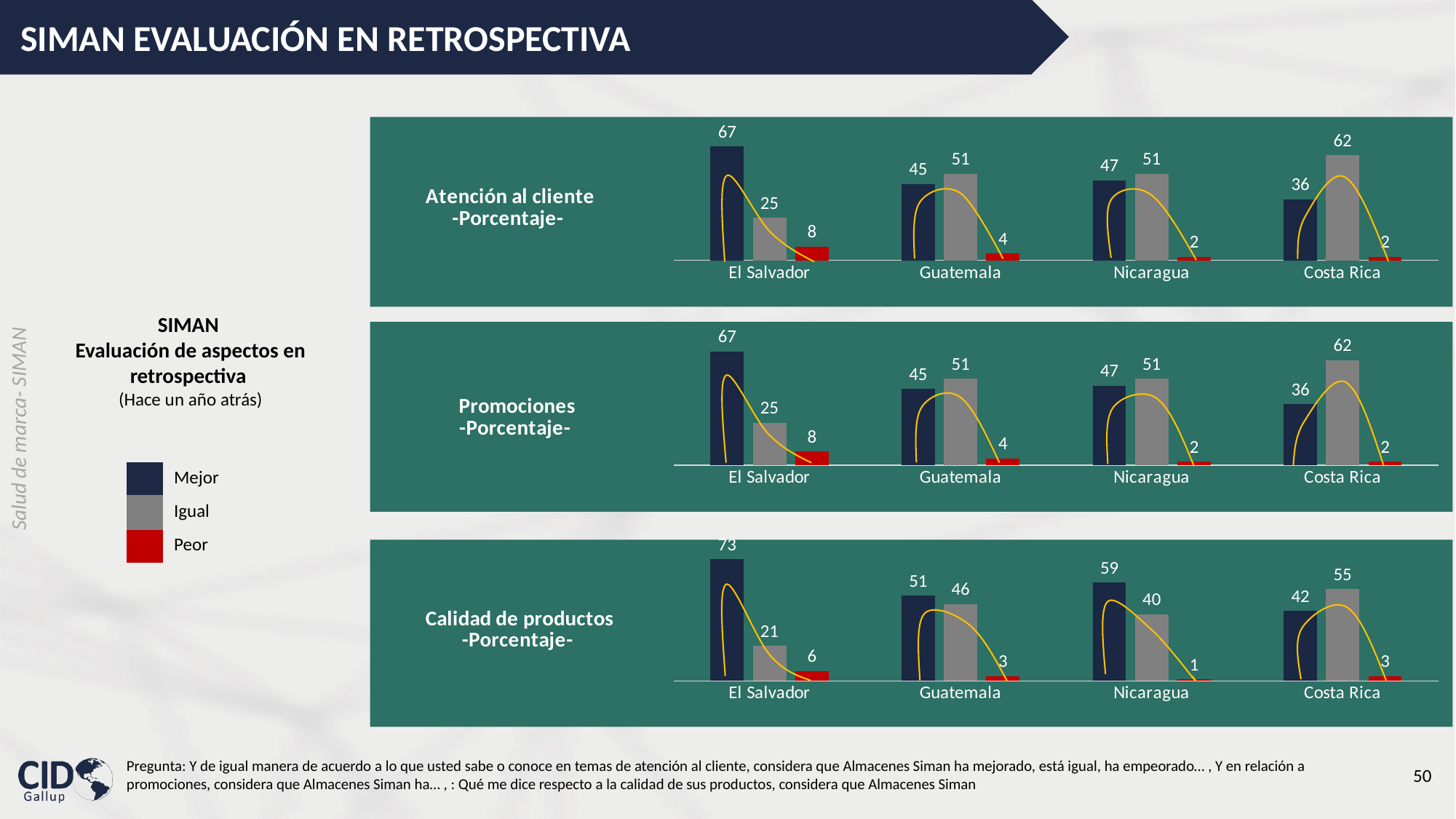
In the 'Promociones' chart, which country has the lowest 'Mejor' value? Costa Rica In the 'Promociones' chart, what is the 'Peor' value for Guatemala? 4 In the 'Calidad de productos' chart, what is the 'Mejor' value for Nicaragua? 59 In the 'Calidad de productos' chart, what is the difference between the 'Mejor' and 'Igual' values for El Salvador? 52 In the 'Atención al cliente' chart, what is the 'Mejor' value for El Salvador? 67 How many countries are shown on the x axis of the 'Calidad de productos' chart? 4 In the 'Atención al cliente' chart, what is the difference between the 'Mejor' values for El Salvador and Costa Rica? 31 In the 'Atención al cliente' chart, which country has the highest 'Igual' value? Costa Rica In the 'Promociones' chart, is the 'Igual' value for Nicaragua larger or smaller than its 'Mejor' value? larger In the 'Calidad de productos' chart, which country has the lowest 'Peor' value? Nicaragua How many series does the legend on the slide list? 3 What type of chart is the 'Atención al cliente' chart? Bar chart